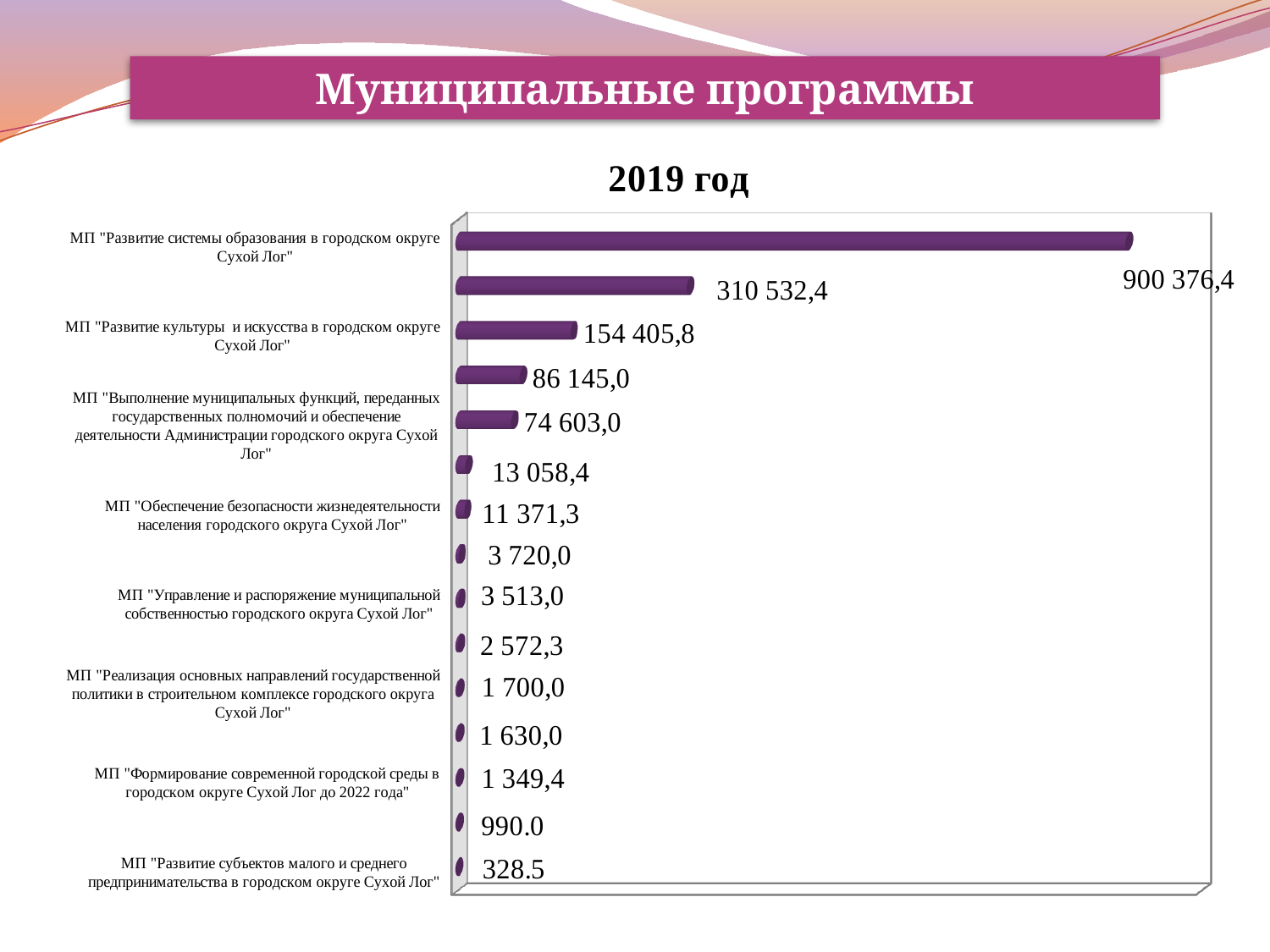
Which is larger: the value for МП "Развитие культуры и искусства" or МП "Выполнение муниципальных функций, переданных государственных полномочий"? МП "Развитие культуры и искусства" Which program has the highest value? МП "Развитие системы образования в городском округе Сухой Лог" What kind of chart is shown on the slide? bar chart What is the value for МП "Формирование современной городской среды в городском округе Сухой Лог до 2022 года"? 1 349,4 What is the difference between the values for МП "Развитие системы образования" and МП "Развитие культуры и искусства"? 745 970,6 What is the value for МП "Развитие системы образования в городском округе Сухой Лог"? 900 376,4 What is the value for МП "Развитие субъектов малого и среднего предпринимательства в городском округе Сухой Лог"? 328.5 Do the bar values increase or decrease going from the top of the chart to the bottom? decrease What is the title of the chart? 2019 год What is the value for МП "Развитие культуры и искусства в городском округе Сухой Лог"? 154 405,8 How many bars are plotted in the chart? 15 Which program has the lowest value? МП "Развитие субъектов малого и среднего предпринимательства в городском округе Сухой Лог"